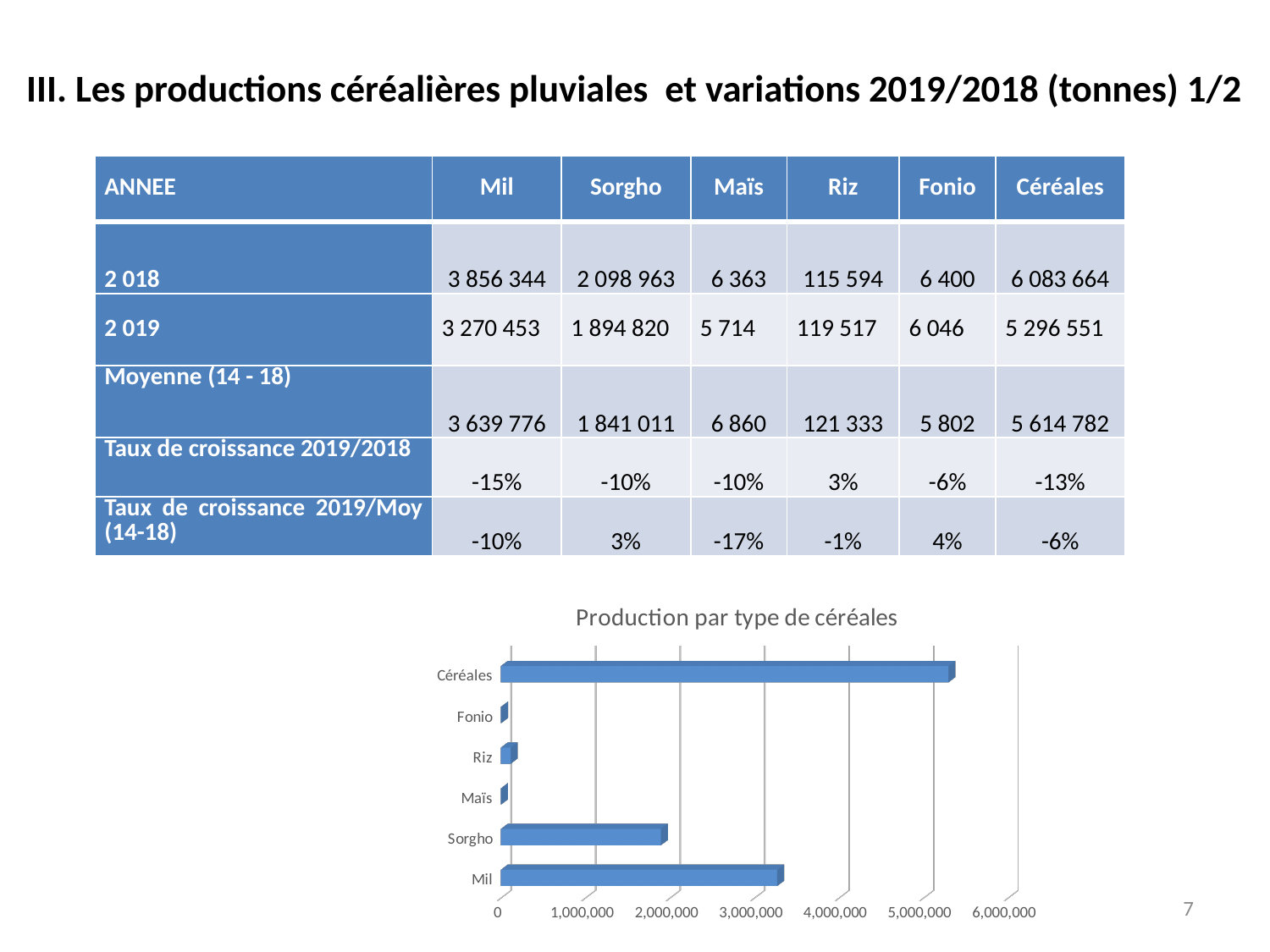
Is the value for Céréales greater or less than 5,000,000? greater What is the highest tick value shown on the horizontal axis of the chart? 6,000,000 Which category has the longest bar in the chart? Céréales Which has the larger value, Riz or Fonio? Riz Is the value for Mil greater or less than 3,000,000? greater What is the title of the chart? Production par type de céréales Which has the larger value, Mil or Sorgho? Mil Is the value for Riz greater or less than 1,000,000? less What type of chart is shown on the slide? bar chart How many categories are plotted in the chart? 6